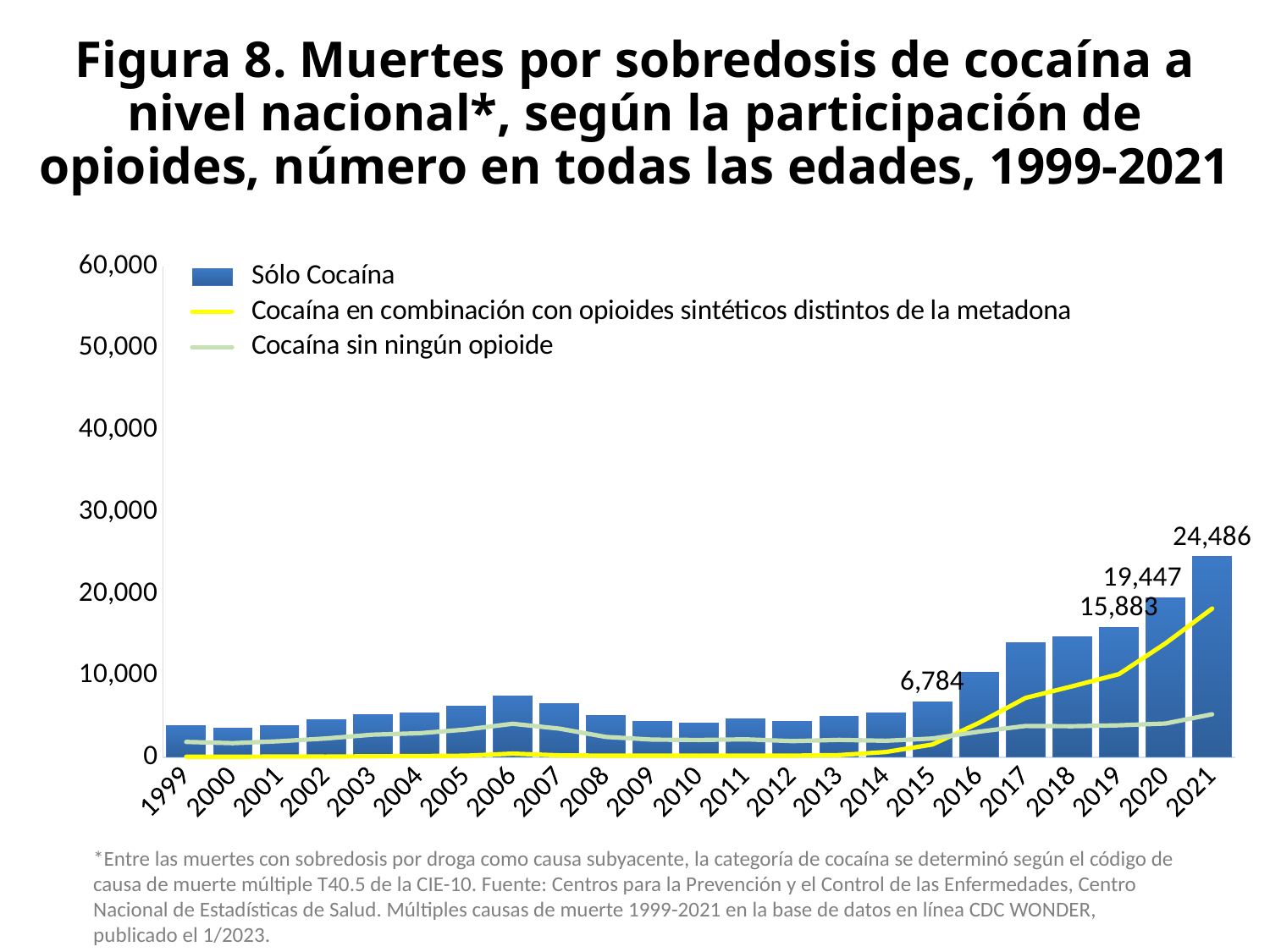
Which is larger, the Sólo Cocaína value for 2015 or for 2021? 2021 What is the difference between the Sólo Cocaína values for 2021 and 2020? 5,039 How many series does the legend list? 3 Do the Sólo Cocaína bars rise or fall from 2015 to 2021? rise What is the value of the Sólo Cocaína bar for 2019? 15,883 What is the difference between the Sólo Cocaína values for 2020 and 2019? 3,564 Is the Sólo Cocaína value for 2017 greater or less than 10,000? greater What is the value of the Sólo Cocaína bar for 2020? 19,447 What is the value of the Sólo Cocaína bar for 2015? 6,784 Which year has the highest Sólo Cocaína bar? 2021 What is the value of the Sólo Cocaína bar for 2021? 24,486 How many years are shown on the x axis? 23